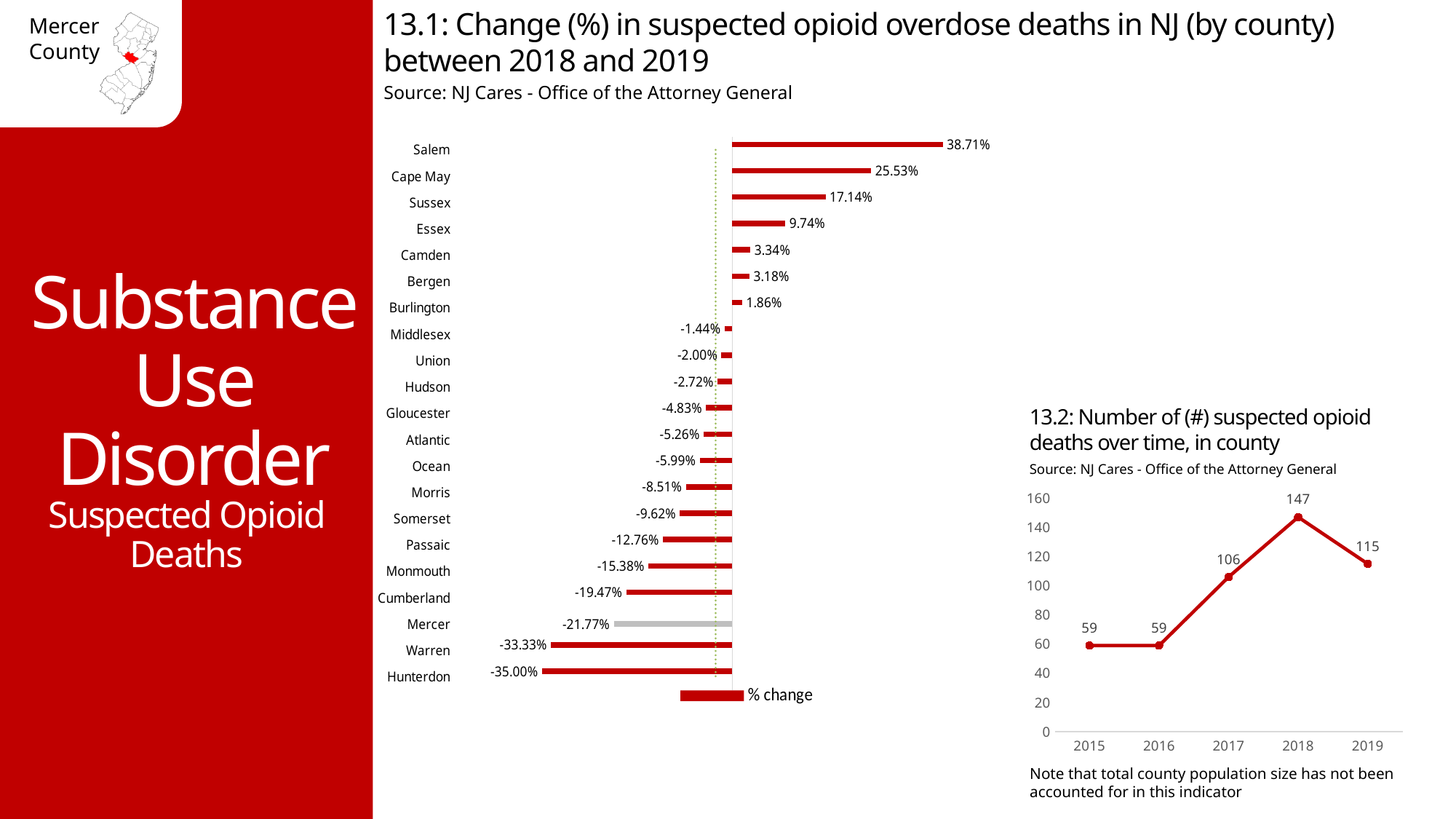
In chart 13.2, which year has the highest number of suspected opioid deaths? 2018 In chart 13.1, which is larger, the % change for Essex or for Sussex? Sussex In chart 13.1, which county has the highest % change? Salem In chart 13.1, which county has the lowest % change? Hunterdon What kind of chart is chart 13.1? Bar chart In chart 13.1, what is the % change for Mercer? -21.77% What kind of chart is chart 13.2? Line chart In chart 13.1, what is the % change for Cape May? 25.53% In chart 13.2, what is the difference in suspected opioid deaths between 2018 and 2019? 32 In chart 13.2, how many suspected opioid deaths were there in 2018? 147 In chart 13.1, what is the difference between the % change for Salem and Cape May? 13.18% In chart 13.1, how many counties are shown? 21